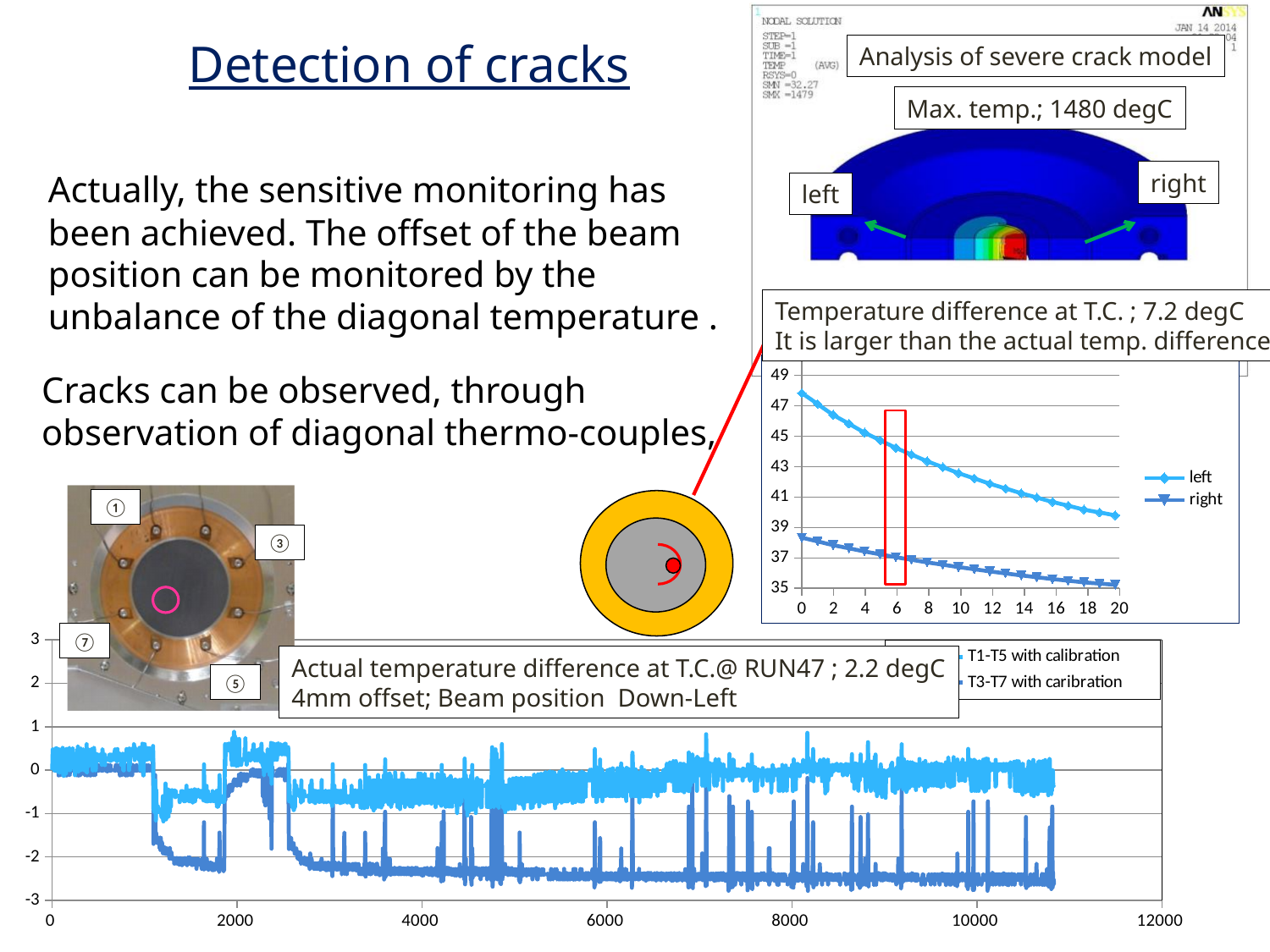
In the chart on the right with x axis from 0 to 20, is the value of the 'left' series at x = 0 greater or less than 45? greater What kind of chart is the chart on the right with x axis from 0 to 20? line chart What kind of chart is the chart at the bottom of the slide with x axis from 0 to 12000? line chart In the chart at the bottom of the slide with x axis from 0 to 12000, how many series does the legend list? 2 In the chart on the right with x axis from 0 to 20, is the value of the 'left' series at x = 20 greater or less than 43? less In the chart on the right with x axis from 0 to 20, do the values of the 'left' series rise or fall as x increases? fall In the chart on the right with x axis from 0 to 20, how many series does the legend list? 2 In the chart on the right with x axis from 0 to 20, which series has the larger value at x = 10, 'left' or 'right'? left In the chart at the bottom of the slide, is the value of the 'T3-T7 with caribration' series at x = 6000 greater or less than -1? less In the chart on the right with x axis from 0 to 20, what are the names of the two series in the legend? left and right In the chart at the bottom of the slide, which series has the larger value at x = 8000, 'T1-T5 with calibration' or 'T3-T7 with caribration'? T1-T5 with calibration